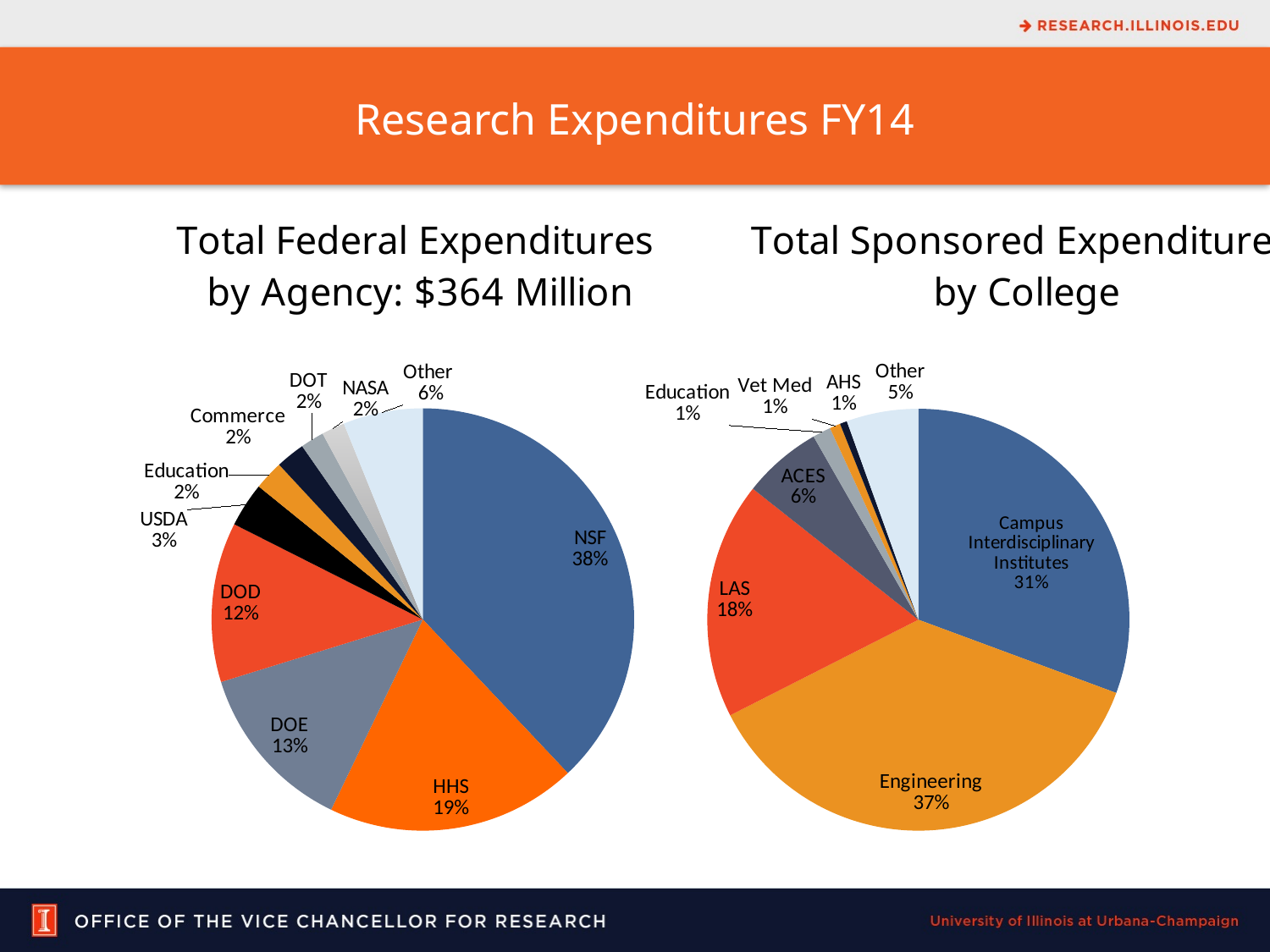
What total dollar amount is stated in the title of the left chart? $364 Million In the Total Sponsored Expenditures by College pie chart, which is larger, LAS or ACES? LAS In the Total Sponsored Expenditures by College pie chart, which college has the largest slice? Engineering How many slices does the Total Sponsored Expenditures by College pie chart have? 8 In the Total Federal Expenditures by Agency pie chart, which agency has the largest slice? NSF In the Total Federal Expenditures by Agency pie chart, what is the difference in percentage points between HHS and DOD? 7 In the Total Sponsored Expenditures by College pie chart, what share does Engineering account for? 37% In the Total Federal Expenditures by Agency pie chart, what share does NSF account for? 38% What type of chart is used for the Total Sponsored Expenditures by College? Pie chart In the Total Federal Expenditures by Agency pie chart, which is larger, DOE or DOD? DOE In the Total Sponsored Expenditures by College pie chart, what is the difference in percentage points between Engineering and Campus Interdisciplinary Institutes? 6 How many slices does the Total Federal Expenditures by Agency pie chart have? 10